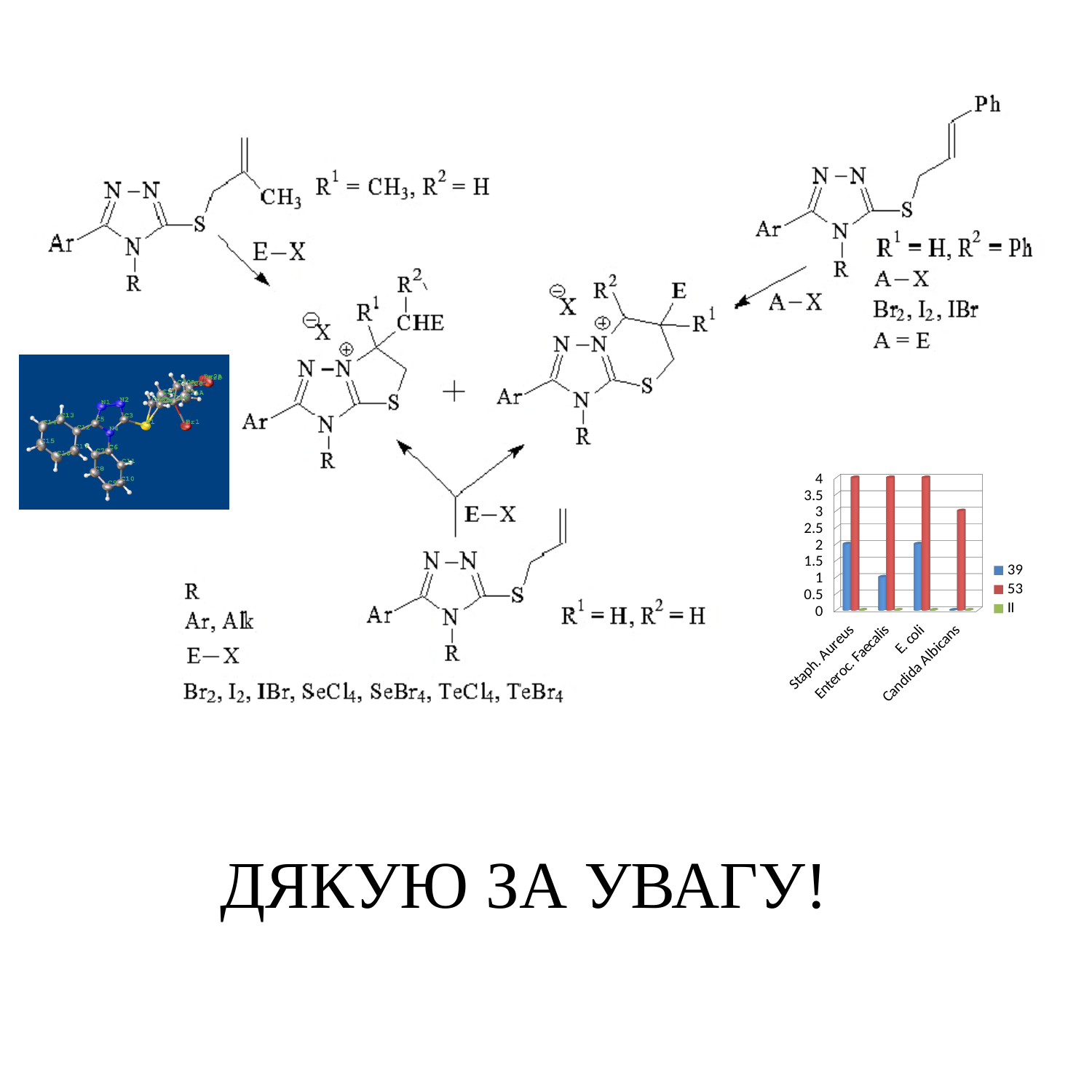
Which category has the lowest value for series 39? Candida Albicans What kind of chart is shown on the slide? bar chart Is the value for series 39 for Staph. Aureus greater or less than 1? greater How many series does the chart legend list? 3 Is the value for series 53 for Staph. Aureus greater or less than 3? greater Which series is shown in red in the chart? 53 How many categories are shown on the x axis of the chart? 4 For series 39, which is larger, Staph. Aureus or Enteroc. Faecalis? Staph. Aureus Is the value for series 39 for Enteroc. Faecalis greater or less than 1.5? less For E. coli, which series has the larger value, 39 or 53? 53 Which category has the lowest value for series 53? Candida Albicans